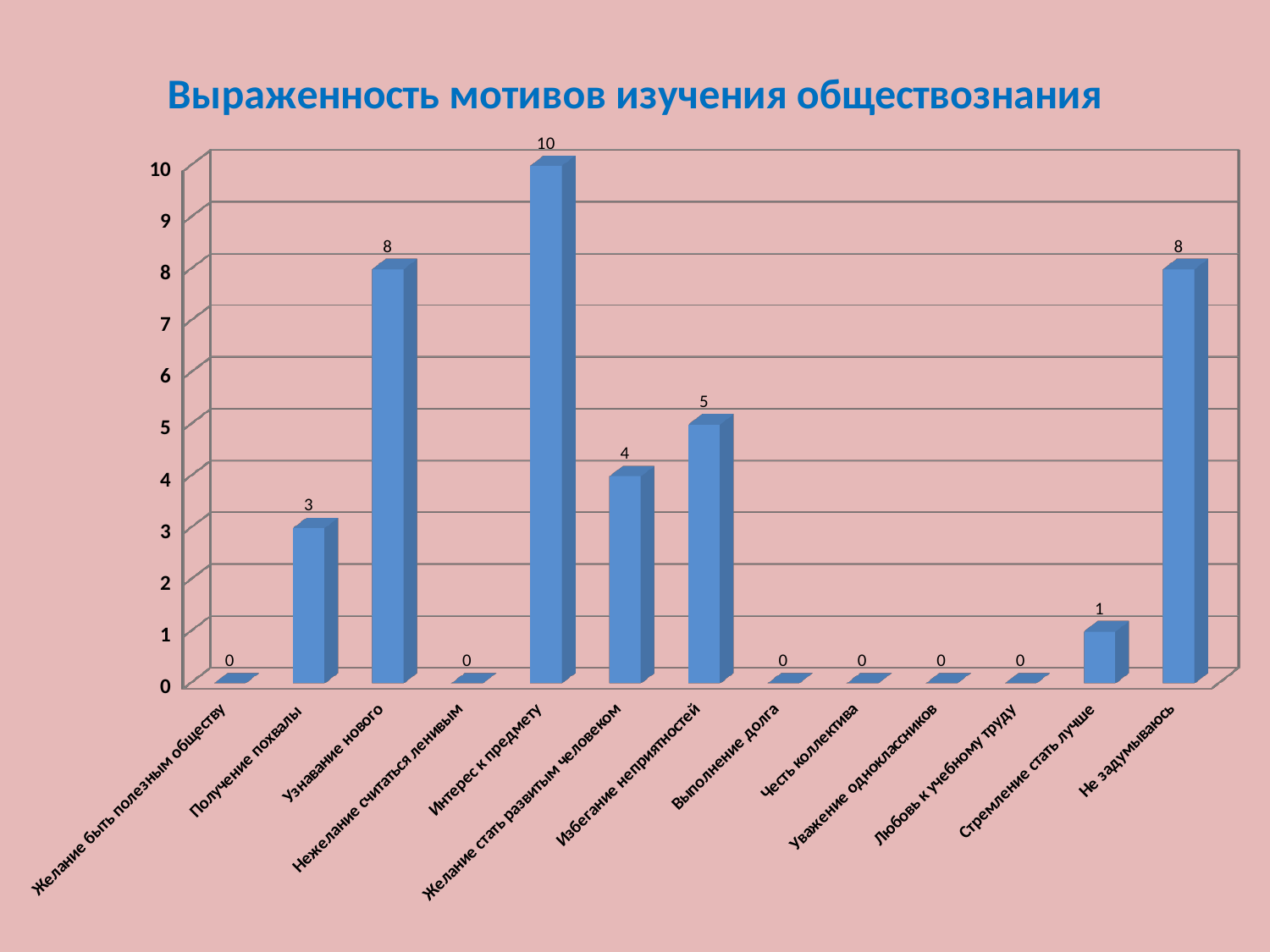
What is the difference between the values for "Узнавание нового" and "Желание стать развитым человеком"? 4 What is the value for "Получение похвалы"? 3 Which is larger, the value for "Избегание неприятностей" or the value for "Получение похвалы"? Избегание неприятностей What is the value for "Интерес к предмету"? 10 What is the title of the chart? Выраженность мотивов изучения обществознания What is the difference between the values for "Интерес к предмету" and "Не задумываюсь"? 2 Which category has the highest value? Интерес к предмету What is the value for "Избегание неприятностей"? 5 What kind of chart is shown on the slide? Bar chart How many categories have a value of 0? 6 What is the value for "Стремление стать лучше"? 1 How many categories are shown on the x axis? 13